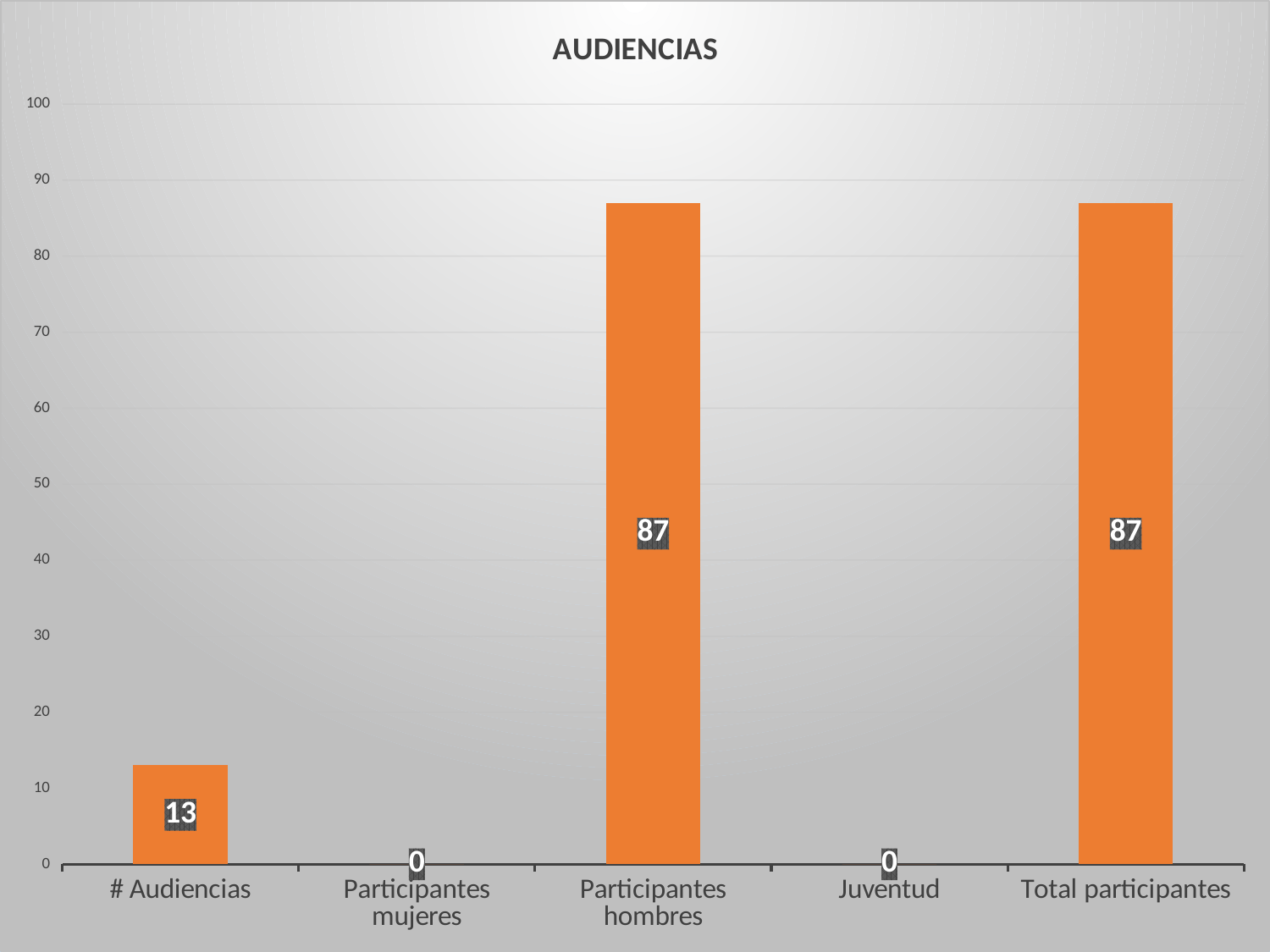
What is the value for # Audiencias? 13 What is the title of the chart? AUDIENCIAS What is the value for Participantes hombres? 87 Which is larger, # Audiencias or Participantes hombres? Participantes hombres How many categories are shown on the x axis? 5 What is the difference between Participantes hombres and # Audiencias? 74 Is the value for Total participantes greater or less than 80? greater What is the value for Juventud? 0 Is the value for # Audiencias greater or less than 20? less What is the value for Participantes mujeres? 0 What is the value for Total participantes? 87 What kind of chart is this? bar chart